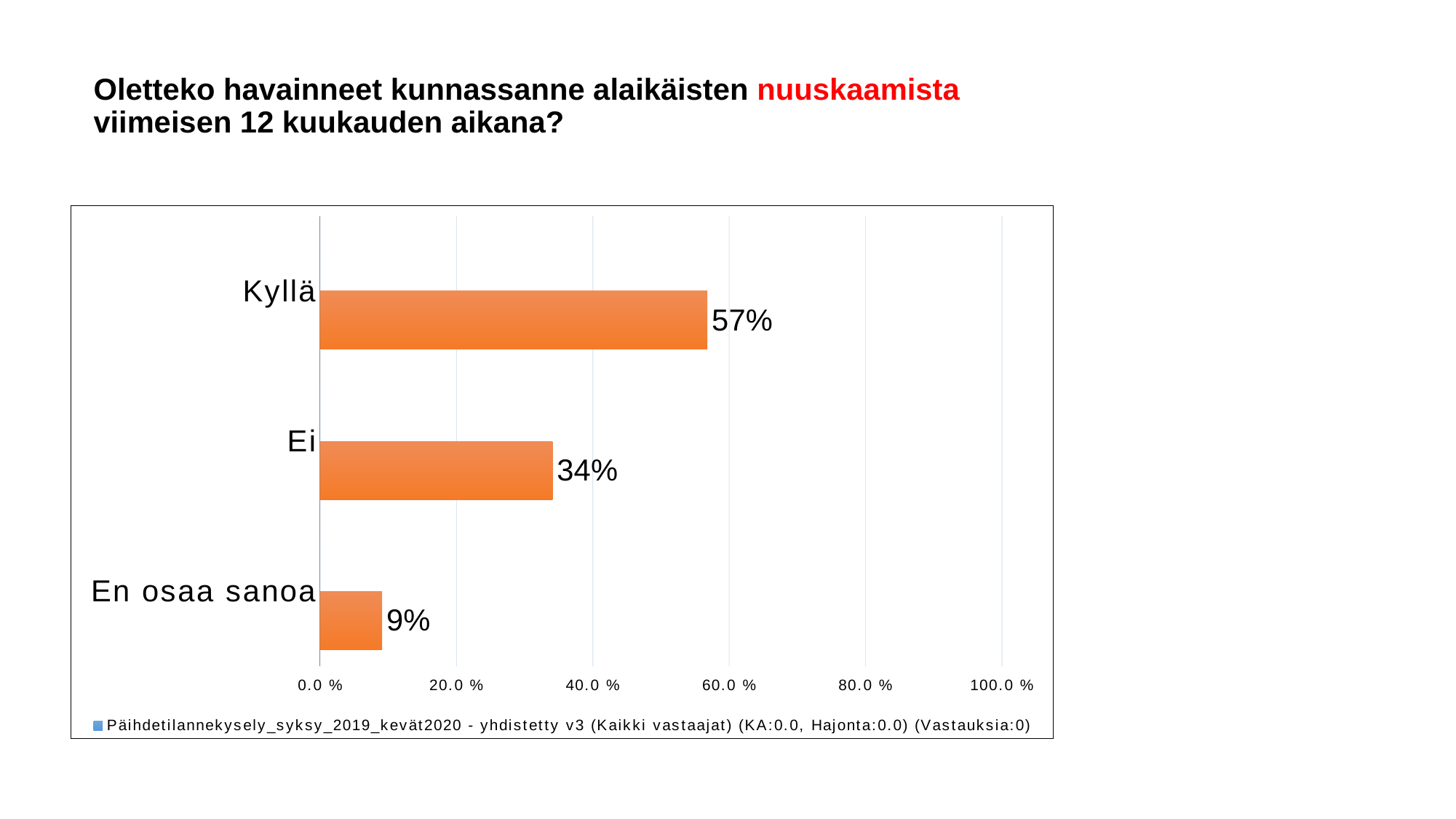
What is the difference between the values for Kyllä and Ei? 23% How many series does the legend list? 1 How many categories are shown in the chart? 3 What is the value for Ei? 34% Which category has the lowest value? En osaa sanoa What is the value for Kyllä? 57% Which category has the highest value? Kyllä What is the value for En osaa sanoa? 9% What is the difference between the values for Ei and En osaa sanoa? 25% Which is larger, the value for Ei or the value for En osaa sanoa? Ei Is the value for Kyllä greater or less than 40.0 %? greater What kind of chart is shown on the slide? bar chart